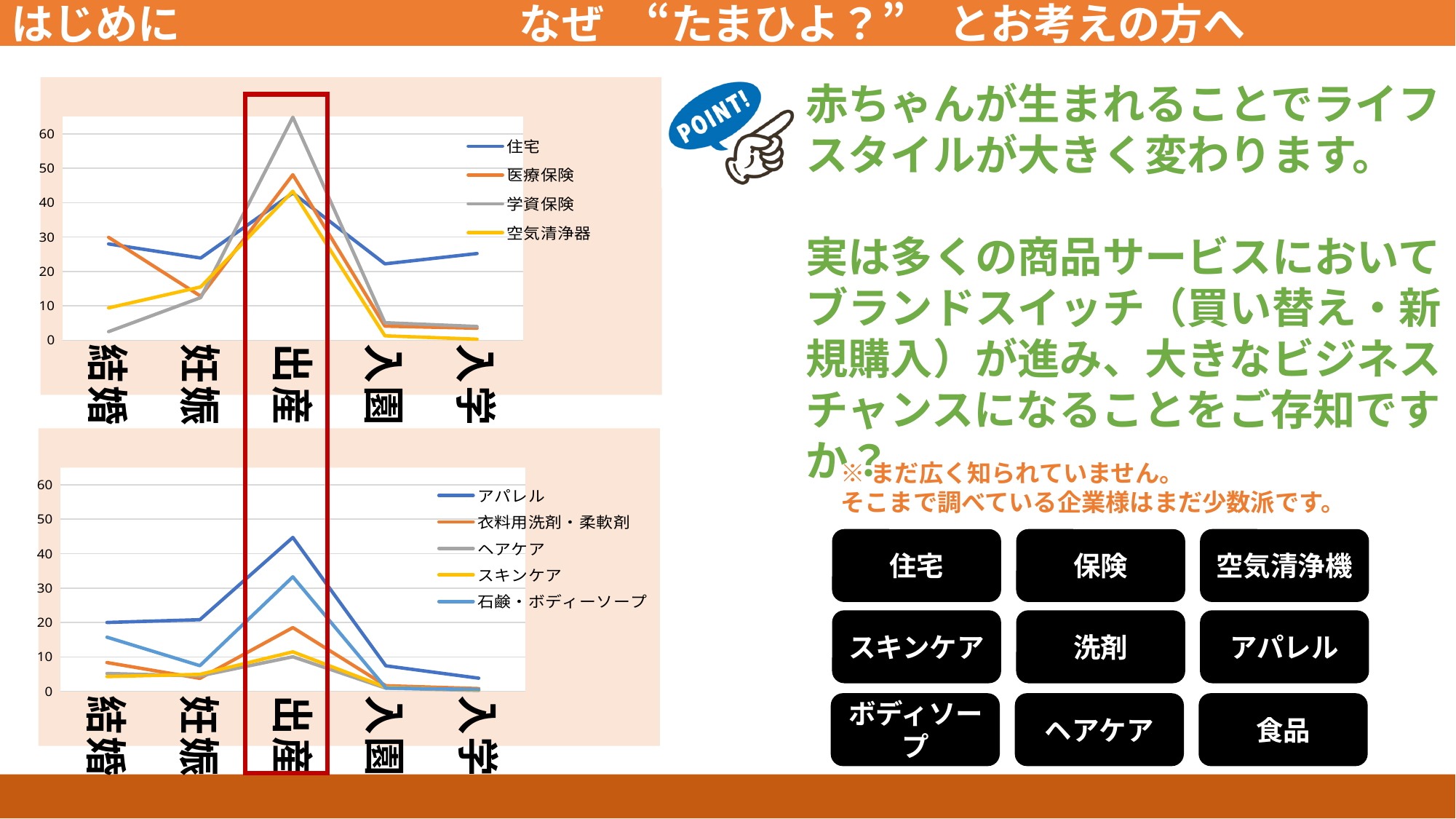
In the bottom chart, which series has the highest value at 出産? アパレル How many series does the legend of the bottom chart list? 5 In the bottom chart, is the value for アパレル at 出産 greater or less than 40? greater How many categories are shown on the x axis of the top chart? 5 How many series does the legend of the top chart list? 4 In the top chart, which series has the highest value at 出産? 学資保険 In the bottom chart, at which category does the アパレル series reach its highest value? 出産 What kind of chart is the top chart on the slide? line chart In the bottom chart, which is larger at 出産: 石鹸・ボディーソープ or ヘアケア? 石鹸・ボディーソープ In the top chart, is the value for 学資保険 at 出産 greater or less than 60? greater In the top chart, do the values for 空気清浄器 rise or fall from 出産 to 入園? fall